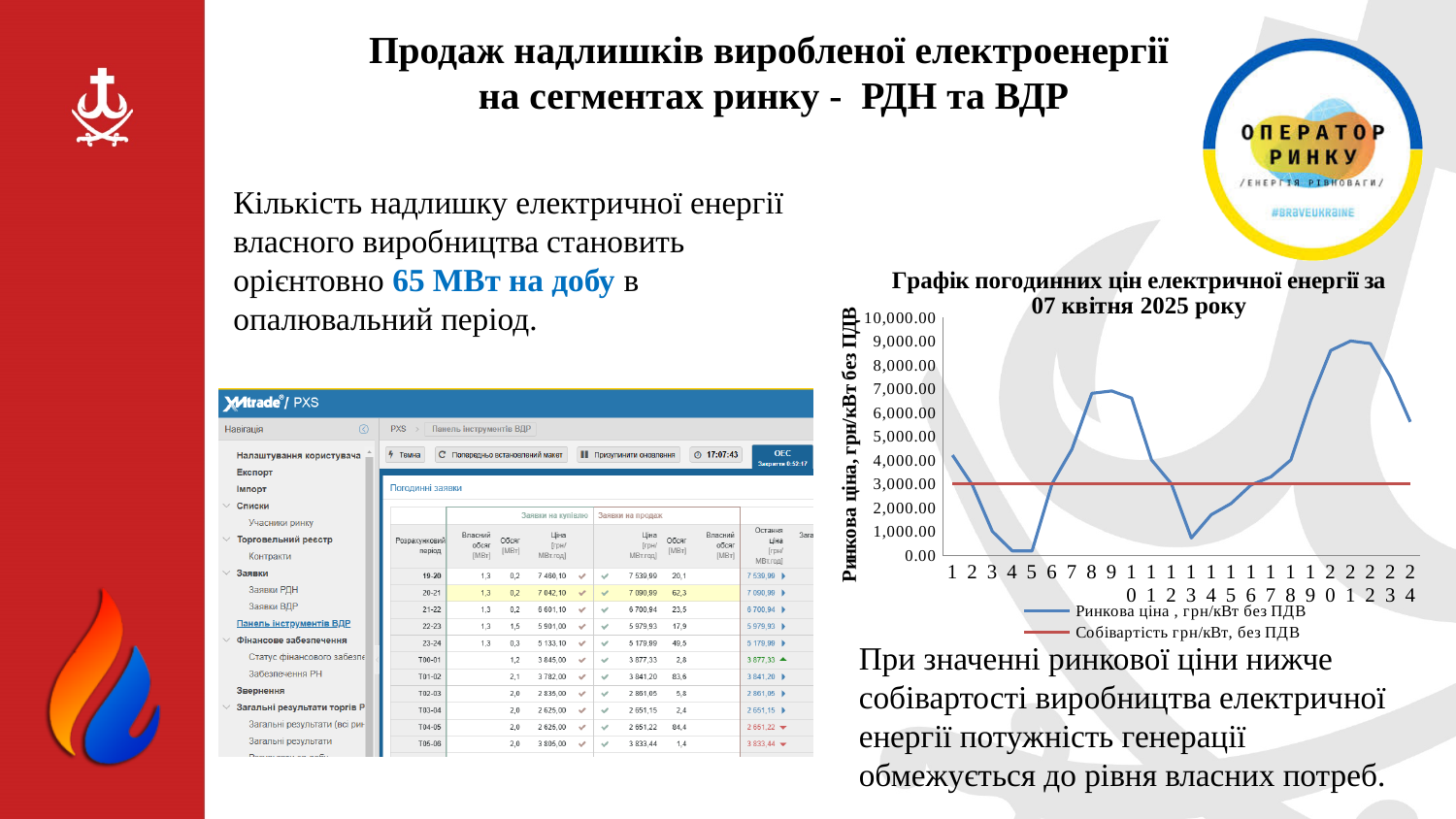
Is the market price (Ринкова ціна) at hour 4 greater or less than 1,000.00? less How many hourly points are plotted along the x axis of the chart? 24 How many series does the chart legend list? 2 What kind of chart is shown on the slide? line chart Does the market price rise or fall from hour 1 to hour 4? fall Does the market price rise or fall from hour 19 to hour 22? rise Is the market price (Ринкова ціна) at hour 22 greater or less than 8,000.00? greater Which is higher, the market price at hour 22 or the market price at hour 8? hour 22 What date does the chart title say the hourly electricity prices are for? 07 квітня 2025 року Is the market price (Ринкова ціна) at hour 8 greater or less than 6,000.00? greater